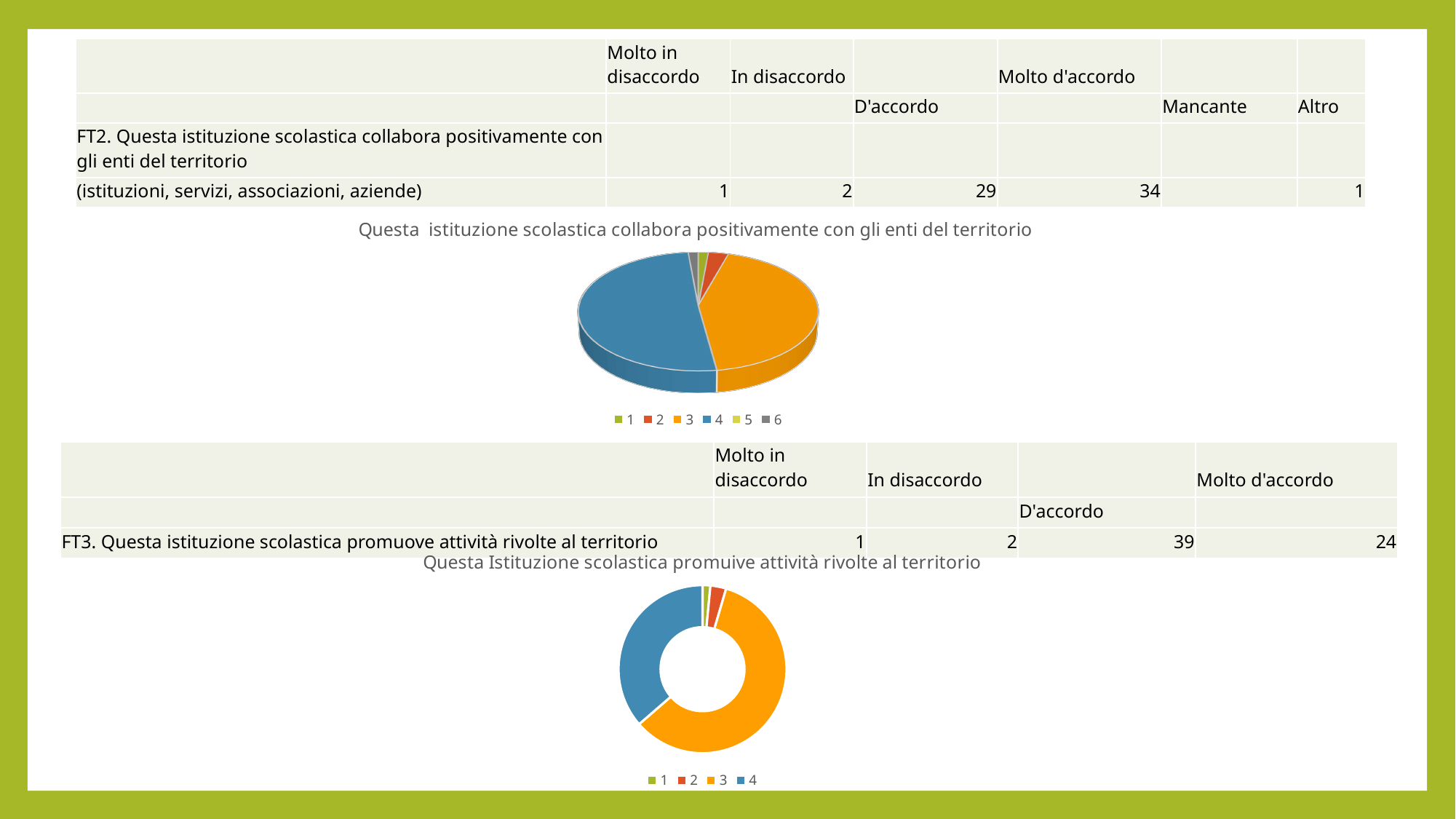
In the bottom doughnut chart, how many entries does the legend list? 4 In the top pie chart, which legend category has the largest slice? 4 What kind of chart is the top chart, titled 'Questa istituzione scolastica collabora positivamente con gli enti del territorio'? pie chart In the bottom doughnut chart, which legend category has the largest slice? 3 What is the title of the bottom doughnut chart? Questa Istituzione scolastica promuive attività rivolte al territorio In the bottom doughnut chart, which slice is larger, category 1 or category 2? 2 In the bottom doughnut chart, which slice is larger, category 3 or category 4? 3 What kind of chart is the bottom chart, titled 'Questa Istituzione scolastica promuive attività rivolte al territorio'? doughnut chart In the bottom doughnut chart, which legend category has the smallest slice? 1 In the top pie chart, which slice is larger, category 3 or category 4? 4 In the top pie chart, how many entries does the legend list? 6 What is the title of the top pie chart? Questa istituzione scolastica collabora positivamente con gli enti del territorio